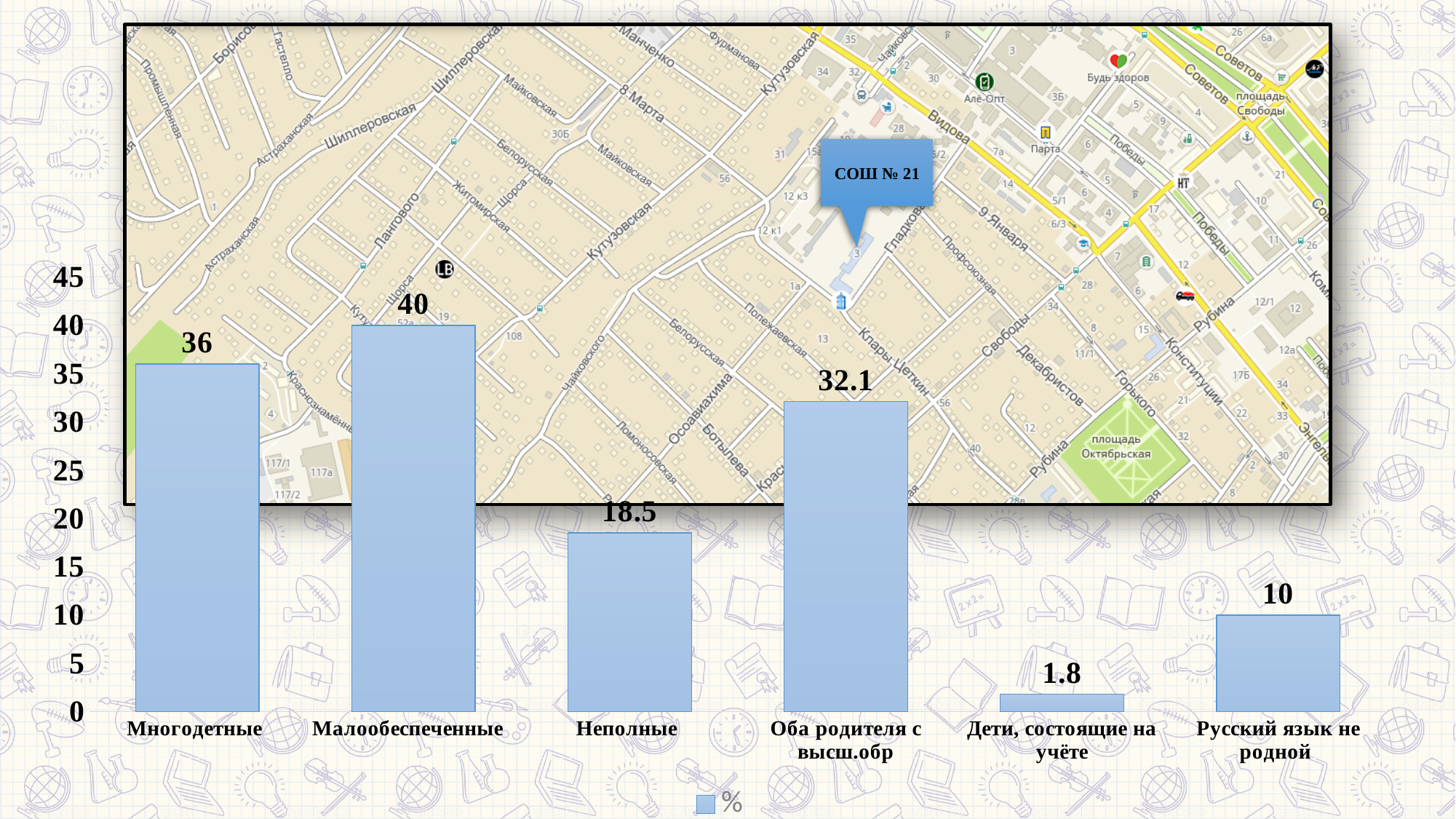
What series name does the legend show? % What is the value for Неполные? 18.5 How many categories are shown on the chart? 6 What kind of chart is shown on the slide? bar chart What is the value for Многодетные? 36 Which category has the lowest value? Дети, состоящие на учёте What is the value for Малообеспеченные? 40 What is the value for Оба родителя с высш.обр? 32.1 Which category has the highest value? Малообеспеченные What is the difference between the values for Малообеспеченные and Многодетные? 4 Which is larger, the value for Неполные or the value for Русский язык не родной? Неполные What is the value for Дети, состоящие на учёте? 1.8